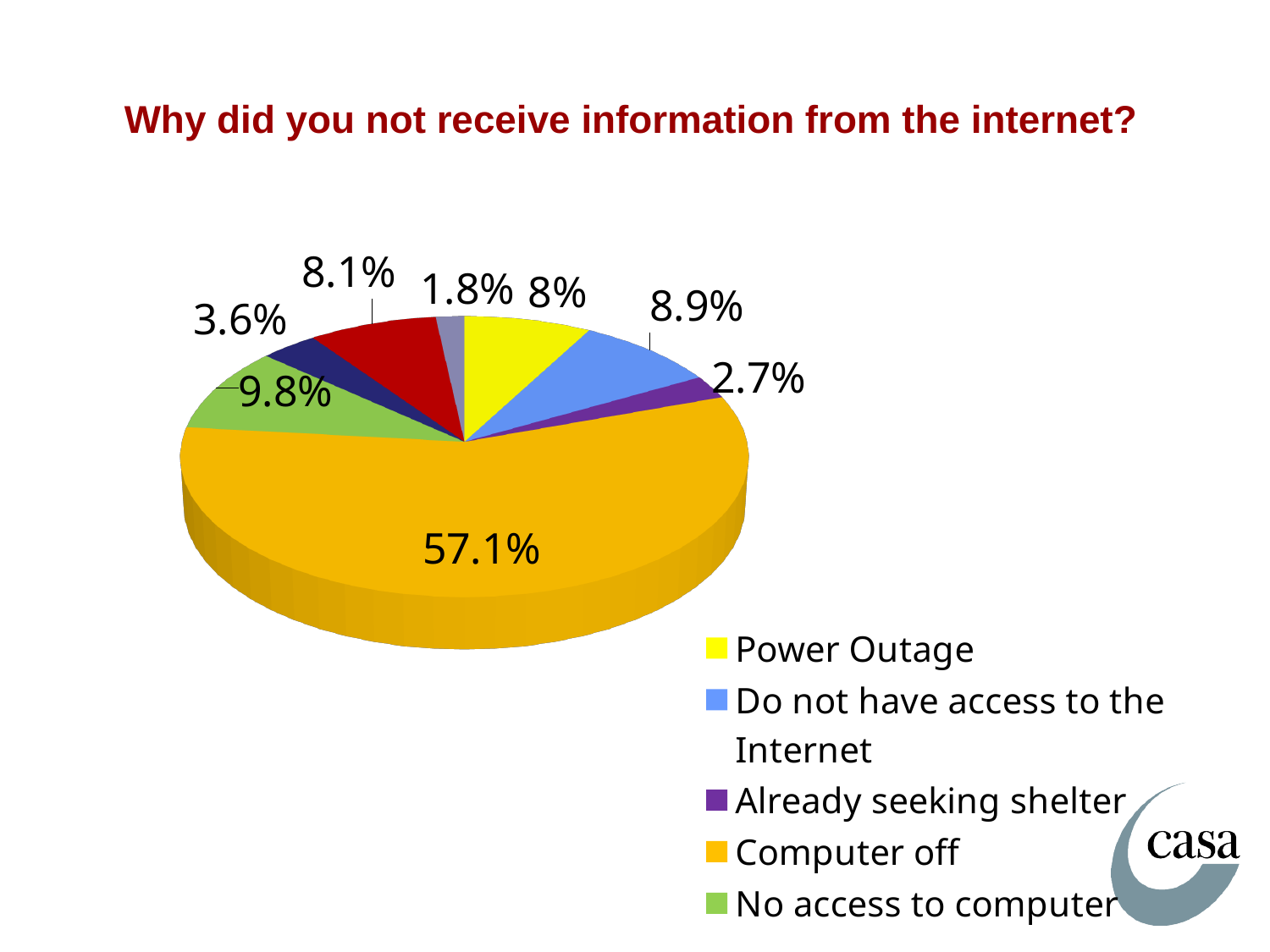
What is the difference between the "Do not have access to the Internet" share and the "Power Outage" share? 0.9% What percentage is shown for "No access to computer"? 9.8% What percentage is shown for "Do not have access to the Internet"? 8.9% What is the difference between the "Computer off" share and the "No access to computer" share? 47.3% What percentage of the pie is labelled for "Computer off"? 57.1% How many slices does the pie chart have? 8 What is the title of the chart? Why did you not receive information from the internet? What percentage is shown for "Already seeking shelter"? 2.7% What type of chart is shown on the slide? Pie chart Which category has the largest slice of the pie? Computer off Which slice is larger: "No access to computer" or "Do not have access to the Internet"? No access to computer What percentage is shown for the "Power Outage" slice? 8%